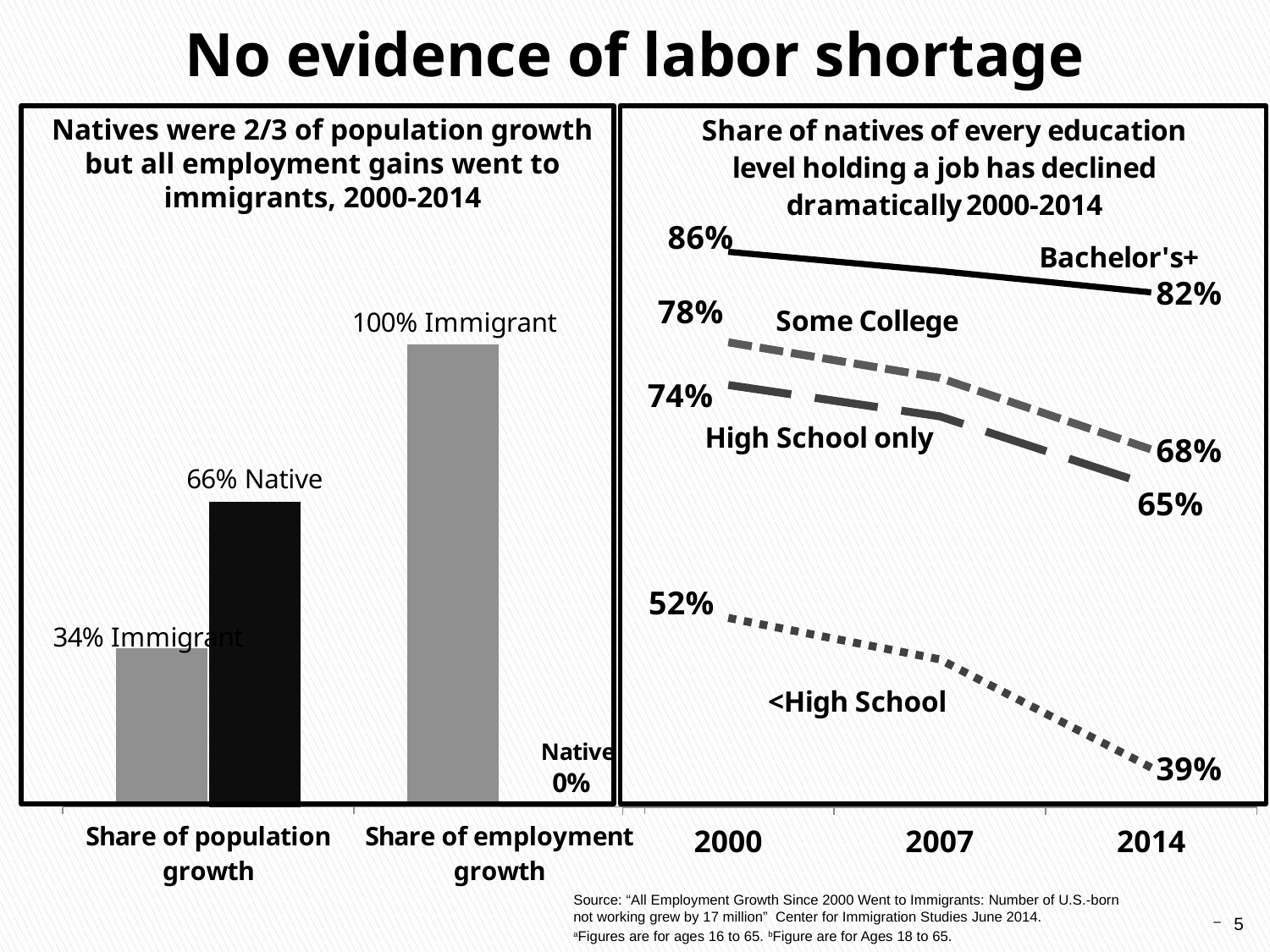
What kind of chart is the left chart? Bar chart In the left chart, what is the native share of employment growth? 0% In the left chart, what is the immigrant share of population growth? 34% In the right chart, what was the share of natives with less than high school holding a job in 2014? 39% In the left chart, which is larger: the native share of population growth or the immigrant share of population growth? Native share of population growth In the right chart, by how much did the share of natives with Some College holding a job fall from 2000 to 2014? 10% In the right chart, how many education-level lines are plotted? 4 In the left chart, what is the difference between the native and immigrant shares of population growth? 32% In the right chart, what was the share of natives with a Bachelor's+ holding a job in 2000? 86% In the right chart, does the share of natives with High School only holding a job rise or fall from 2000 to 2014? Fall In the right chart, which education level had the lowest share holding a job in 2014? <High School In the left chart, what is the immigrant share of employment growth? 100%